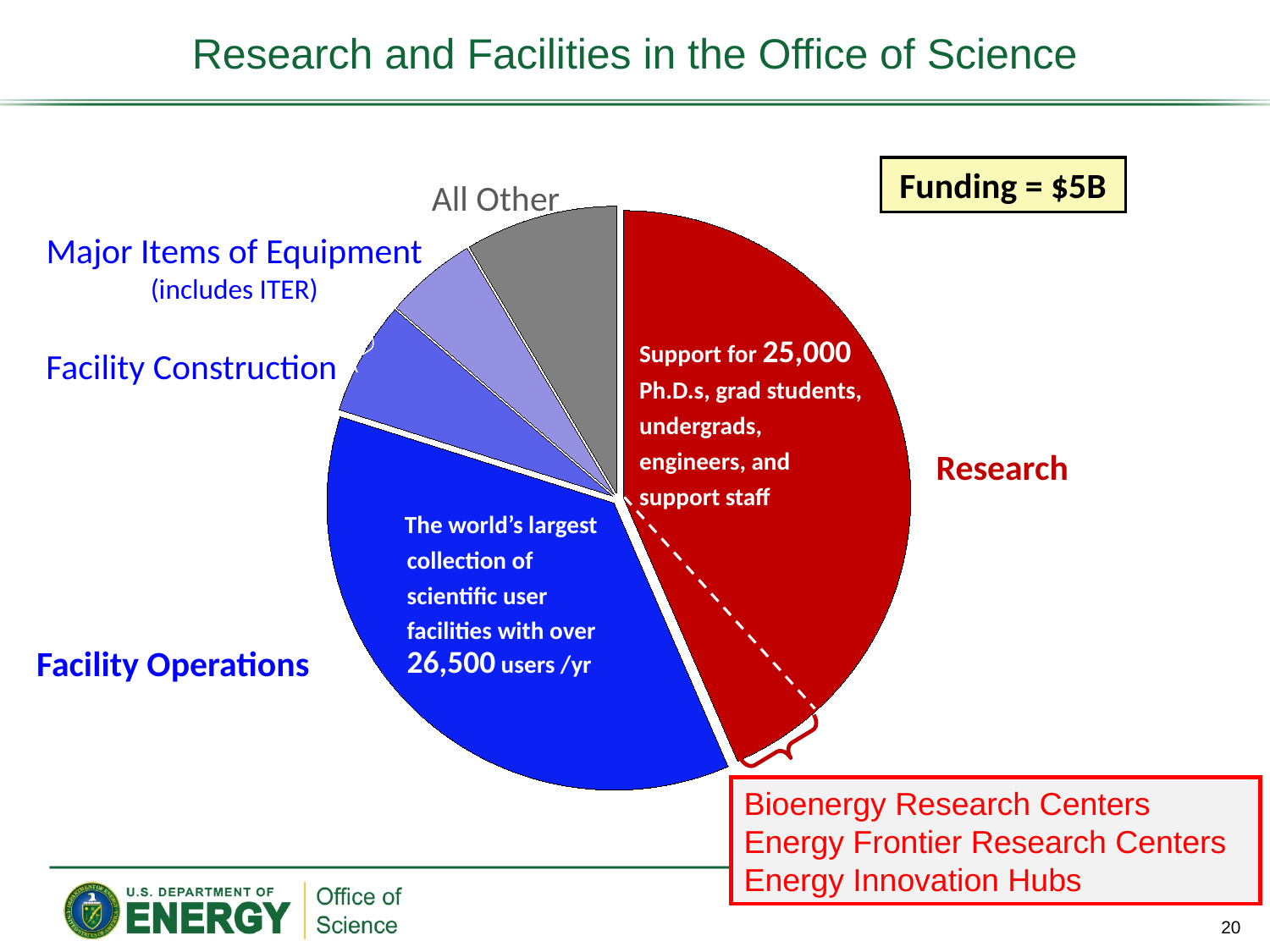
What kind of chart is shown on the slide? pie chart According to the label on the Research slice, how many Ph.D.s, grad students, undergrads, engineers, and support staff are supported? 25,000 Which is larger in the pie chart, Facility Operations or All Other? Facility Operations Which is larger in the pie chart, the Research slice or the All Other slice? Research Which is larger in the pie chart, Facility Operations or Major Items of Equipment? Facility Operations What colour is the Research slice of the pie chart? red According to the label on the Facility Operations slice, how many users per year do the scientific user facilities have? over 26,500 users/yr Which slice of the pie chart is noted as including ITER? Major Items of Equipment How many slices does the pie chart have? 5 What total funding amount is stated for the pie chart? $5B